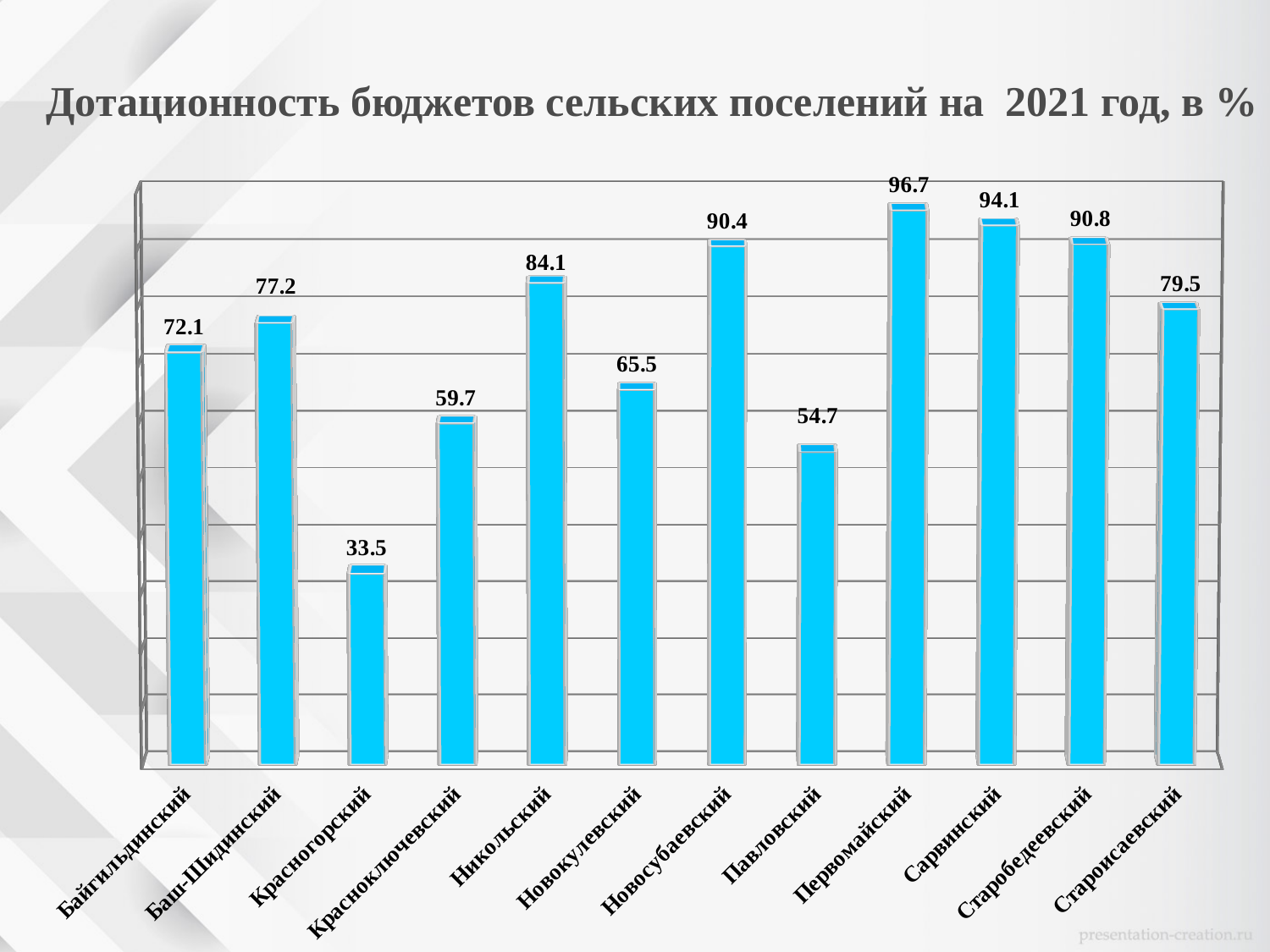
Which settlement has the lowest value? Красногорский What is the difference between the values for Баш-Шидинский and Байгильдинский? 5.1 Which settlement has the highest value? Первомайский What is the difference between the values for Сарвинский and Павловский? 39.4 What is the value for Новокулевский? 65.5 What is the value for Первомайский? 96.7 What kind of chart is shown on the slide? Bar chart What is the title of the chart? Дотационность бюджетов сельских поселений на 2021 год, в % Which is larger, the value for Никольский or the value for Староисаевский? Никольский Which is larger, the value for Красноключевский or the value for Павловский? Красноключевский How many settlements are shown in the chart? 12 What is the value for Красногорский? 33.5